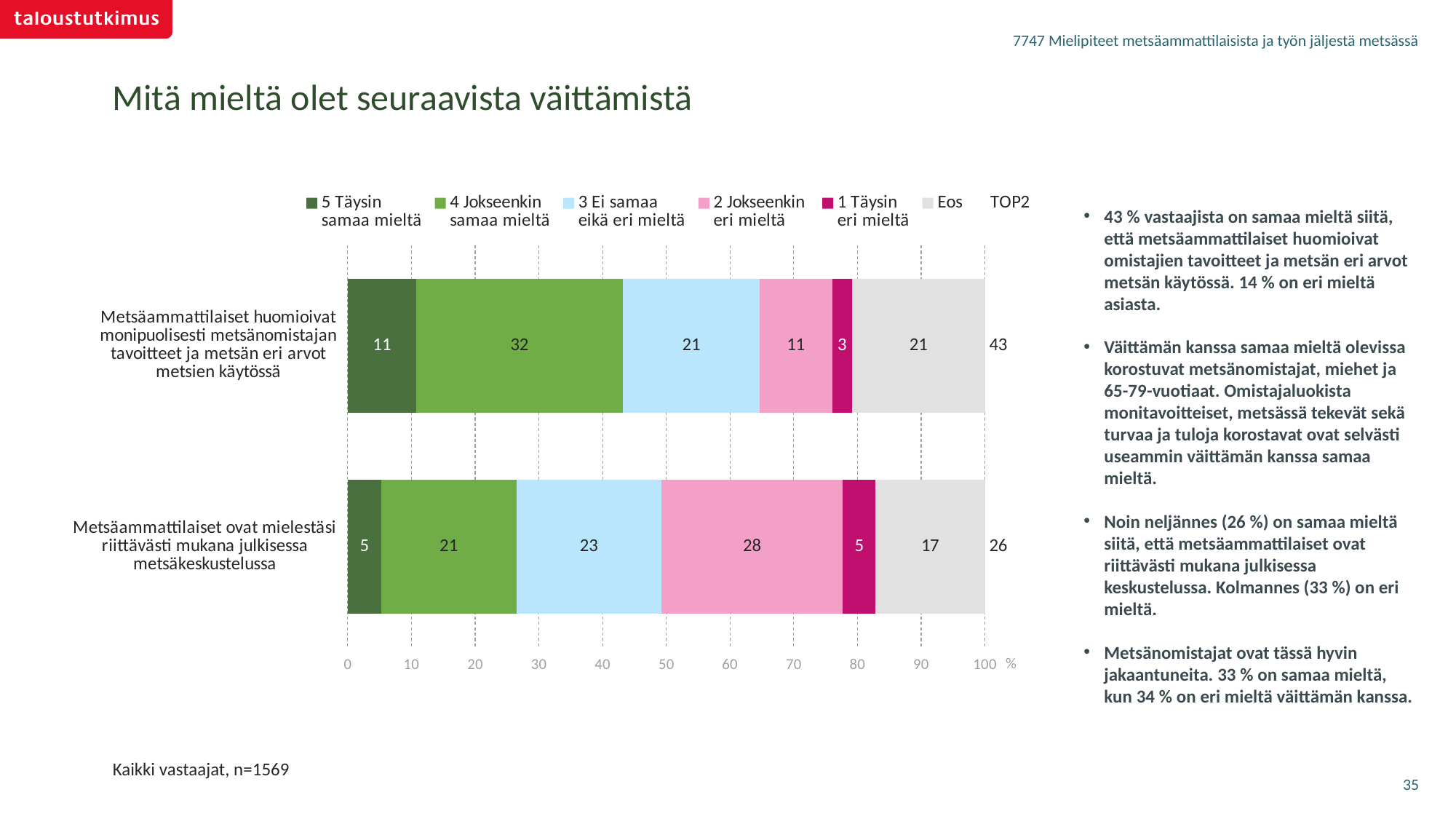
What is the value of '1 Täysin eri mieltä' for the statement 'Metsäammattilaiset huomioivat monipuolisesti metsänomistajan tavoitteet ja metsän eri arvot metsien käytössä'? 3 What kind of chart is shown on the slide? Stacked bar chart How many coloured series does the legend list? 6 What is the title of the chart? Mitä mieltä olet seuraavista väittämistä What is the total of the '2 Jokseenkin eri mieltä' and '1 Täysin eri mieltä' segments for the statement 'Metsäammattilaiset ovat mielestäsi riittävästi mukana julkisessa metsäkeskustelussa'? 33 What is the value of '2 Jokseenkin eri mieltä' for the statement 'Metsäammattilaiset ovat mielestäsi riittävästi mukana julkisessa metsäkeskustelussa'? 28 What is the value of '4 Jokseenkin samaa mieltä' for the statement 'Metsäammattilaiset huomioivat monipuolisesti metsänomistajan tavoitteet ja metsän eri arvot metsien käytössä'? 32 Which statement has the larger 'Eos' value? Metsäammattilaiset huomioivat monipuolisesti metsänomistajan tavoitteet ja metsän eri arvot metsien käytössä What is the difference between the '5 Täysin samaa mieltä' values of the two statements? 6 What is the TOP2 value for the statement 'Metsäammattilaiset ovat mielestäsi riittävästi mukana julkisessa metsäkeskustelussa'? 26 Which statement has the higher TOP2 value? Metsäammattilaiset huomioivat monipuolisesti metsänomistajan tavoitteet ja metsän eri arvot metsien käytössä How many statements (categories) are plotted in the chart? 2